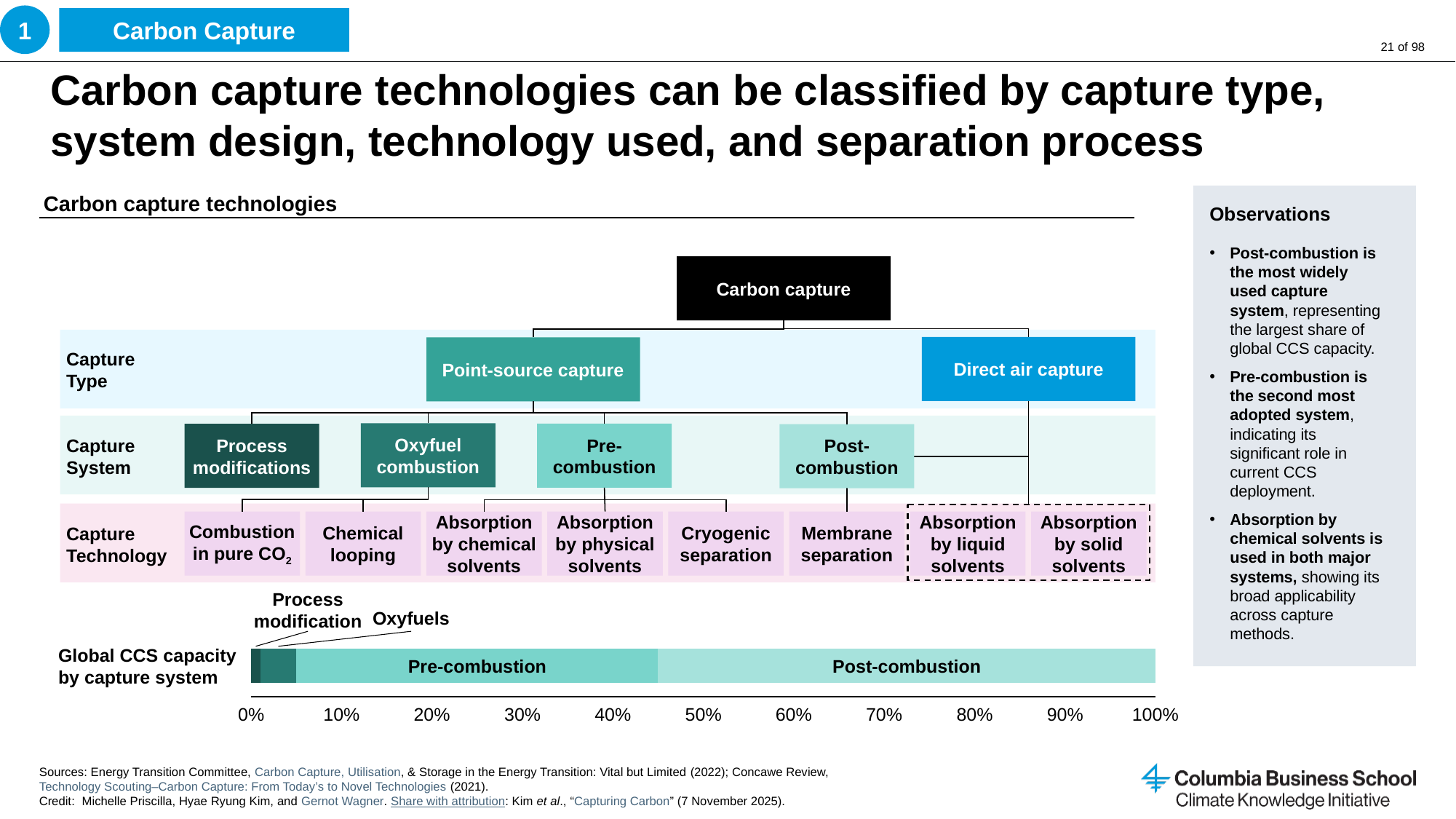
In the 'Global CCS capacity by capture system' chart, which capture system has the smallest share? Process modification How many capture-system segments make up the 'Global CCS capacity by capture system' bar? 4 In the 'Global CCS capacity by capture system' chart, is the share for Pre-combustion greater or less than 50%? less What is the highest value shown on the x axis of the 'Global CCS capacity by capture system' chart? 100% In the 'Global CCS capacity by capture system' chart, is the share for Oxyfuels greater or less than 10%? less Which segment of the 'Global CCS capacity by capture system' bar is shown in the lightest shade of teal? Post-combustion In the 'Global CCS capacity by capture system' chart, which is larger: the Oxyfuels segment or the Pre-combustion segment? Pre-combustion In the 'Global CCS capacity by capture system' chart, which capture system has the largest share? Post-combustion In the 'Global CCS capacity by capture system' chart, which is larger: the Pre-combustion segment or the Post-combustion segment? Post-combustion In the 'Global CCS capacity by capture system' chart, is the share for Post-combustion greater or less than 40%? greater What kind of chart is the 'Global CCS capacity by capture system' chart? bar chart